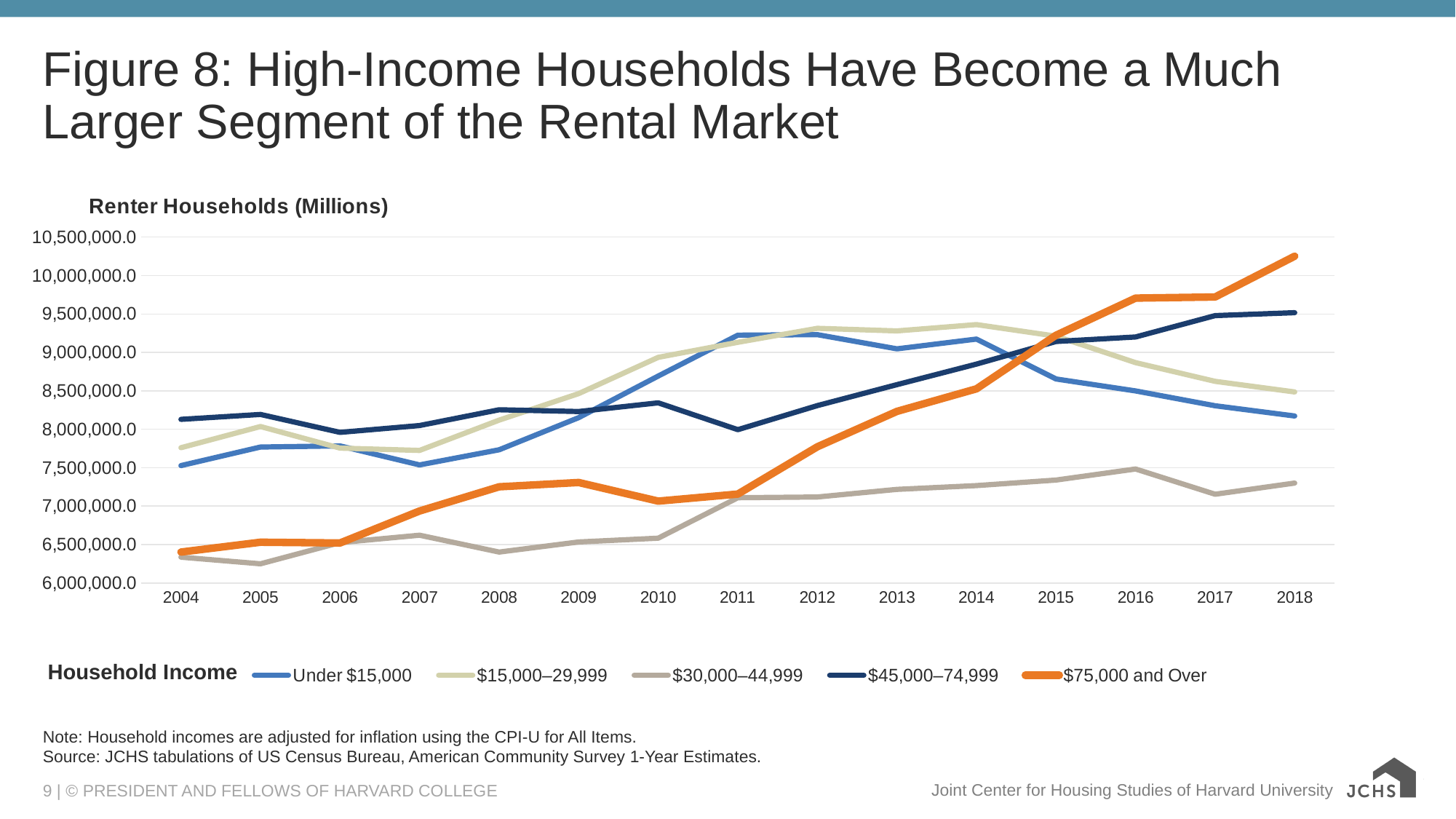
Is the value for $75,000 and Over in 2018 greater or less than 10,000,000.0? greater What kind of chart is shown on the slide? line chart In 2018, which is larger: the value for $75,000 and Over or the value for Under $15,000? $75,000 and Over Is the value for $30,000–44,999 in 2004 greater or less than 6,500,000.0? less How many series does the legend list? 5 What is the title of the y axis? Renter Households (Millions) Which household income group has the highest number of renter households in 2004? $45,000–74,999 Does the $75,000 and Over line rise or fall from 2004 to 2018? rise Which household income group has the lowest number of renter households in 2018? $30,000–44,999 Is the value for $45,000–74,999 in 2018 greater or less than 9,000,000.0? greater Which household income group has the highest number of renter households in 2018? $75,000 and Over How many years are plotted along the x axis? 15